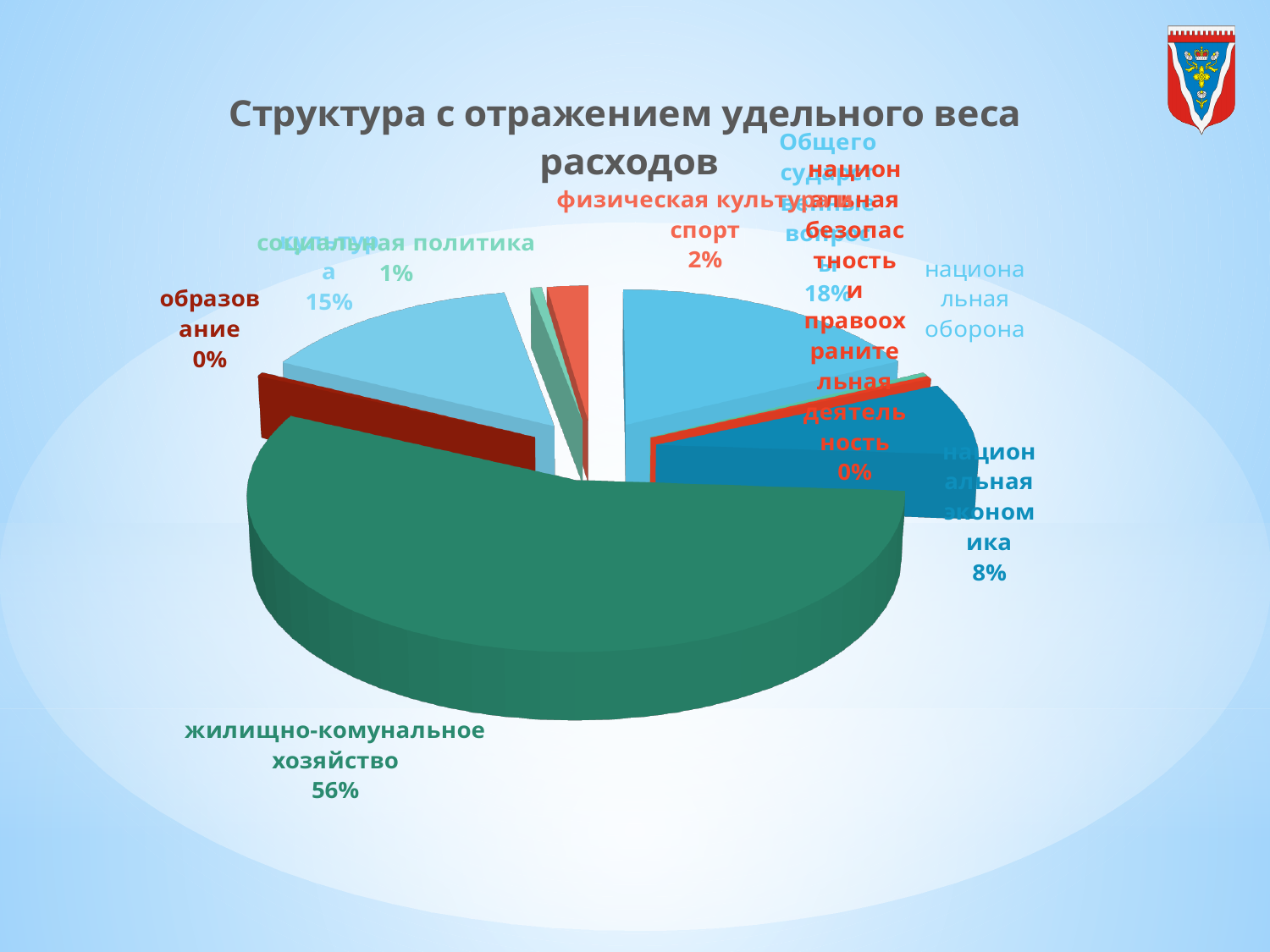
What share is shown for физическая культура и спорт? 2% What share is shown for социальная политика? 1% What is the difference between the share for жилищно-комунальное хозяйство and the share for социальная политика? 55% What is the title of the chart? Структура с отражением удельного веса расходов What share is shown for образование? 0% What share is shown for национальная экономика? 8% Which category has the largest share of expenditures? жилищно-комунальное хозяйство What kind of chart is shown on the slide? pie chart What share of expenditures does жилищно-комунальное хозяйство account for? 56% What is the difference between the share for национальная экономика and the share for физическая культура и спорт? 6% Which is larger, the share for социальная политика or the share for национальная экономика? национальная экономика What share is shown for культура? 15%